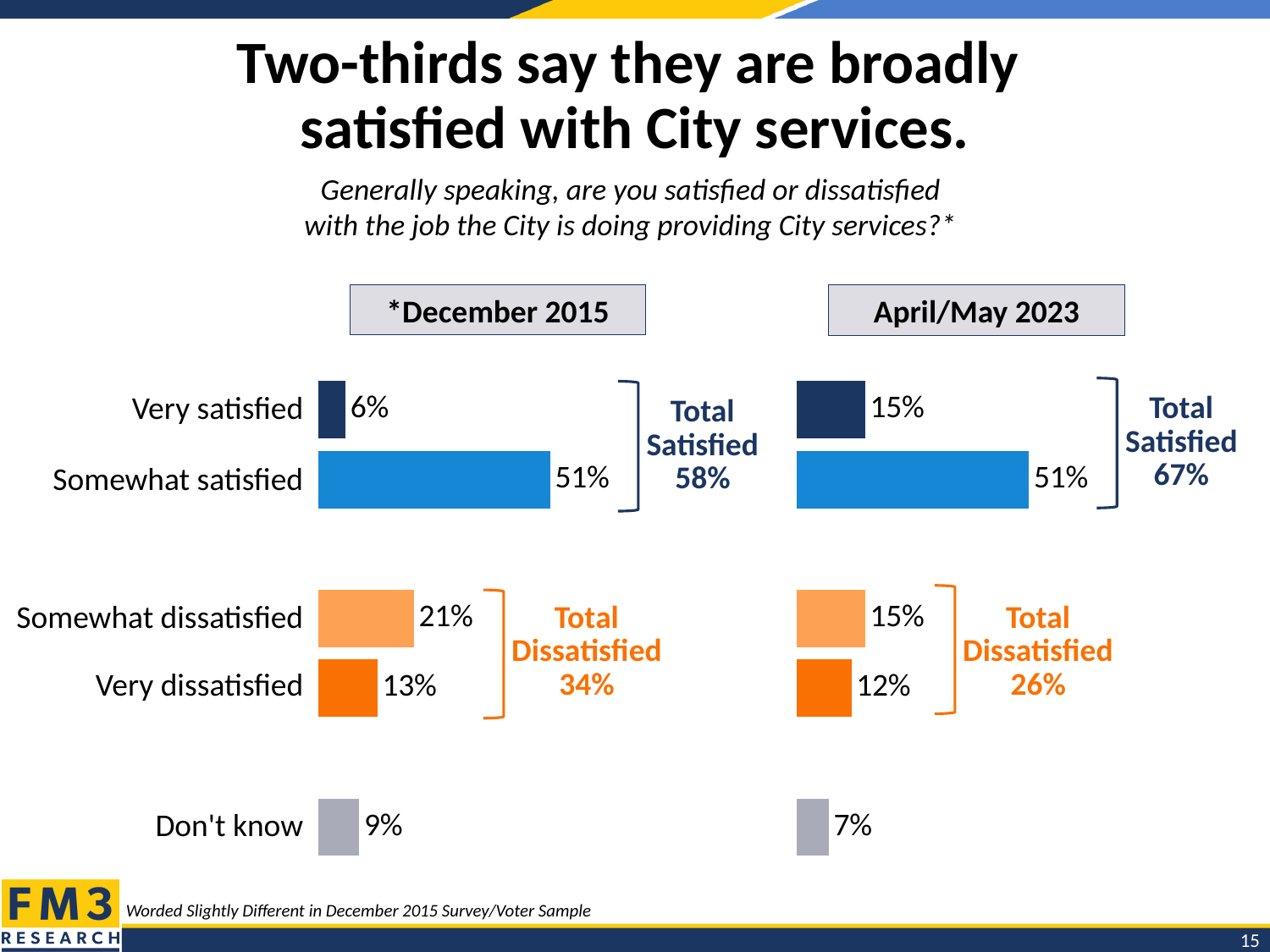
In the December 2015 chart, which is larger: somewhat dissatisfied or very dissatisfied? Somewhat dissatisfied In the December 2015 chart, which response category has the highest percentage? Somewhat satisfied In the December 2015 chart, what percentage answered don't know? 9% What is the Total Satisfied figure shown for the April/May 2023 chart? 67% What is the difference between the very satisfied percentages in the April/May 2023 chart and the December 2015 chart? 9 percentage points In the April/May 2023 chart, what percentage said they were somewhat dissatisfied? 15% In the April/May 2023 chart, which response category has the lowest percentage? Don't know What type of chart is used on this slide? Bar chart In the April/May 2023 chart, what percentage said they were very satisfied? 15% In the December 2015 chart, what percentage said they were very satisfied? 6% What is the Total Dissatisfied figure shown for the December 2015 chart? 34% How many response categories are shown in each chart? 5